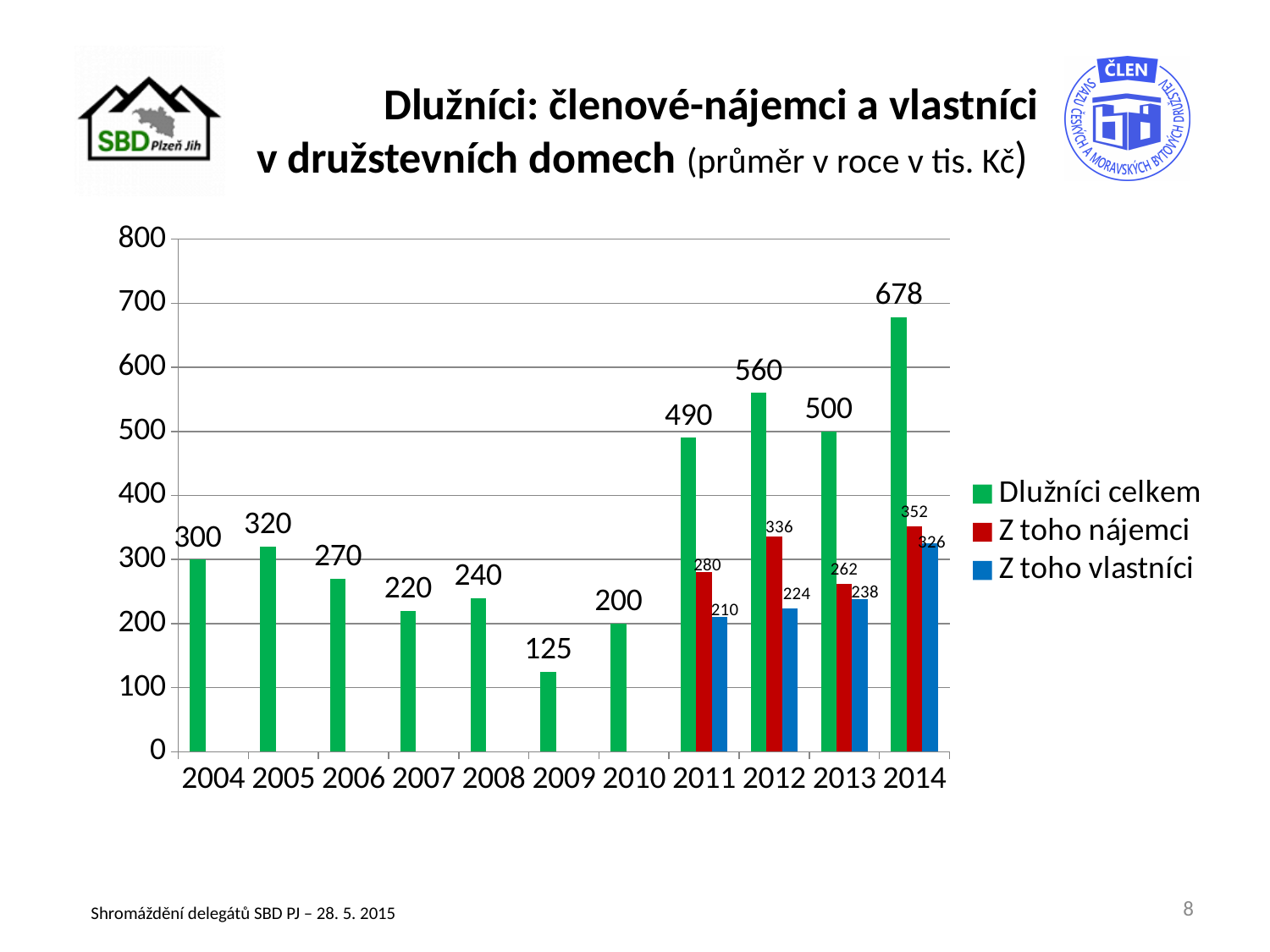
Which colour represents Z toho vlastníci in the legend? Blue Which year has the highest value for Dlužníci celkem? 2014 Which is larger: Z toho nájemci in 2013 or Z toho vlastníci in 2013? Z toho nájemci What is the value of Z toho nájemci for 2012? 336 Which year has the lowest value for Dlužníci celkem? 2009 What kind of chart is shown on the slide? Bar chart What is the value of Dlužníci celkem for 2014? 678 How many years are shown on the x axis? 11 How many series does the legend list? 3 What is the difference between Dlužníci celkem in 2014 and in 2013? 178 What is the value of Z toho vlastníci for 2011? 210 Does Dlužníci celkem rise or fall from 2010 to 2012? Rise